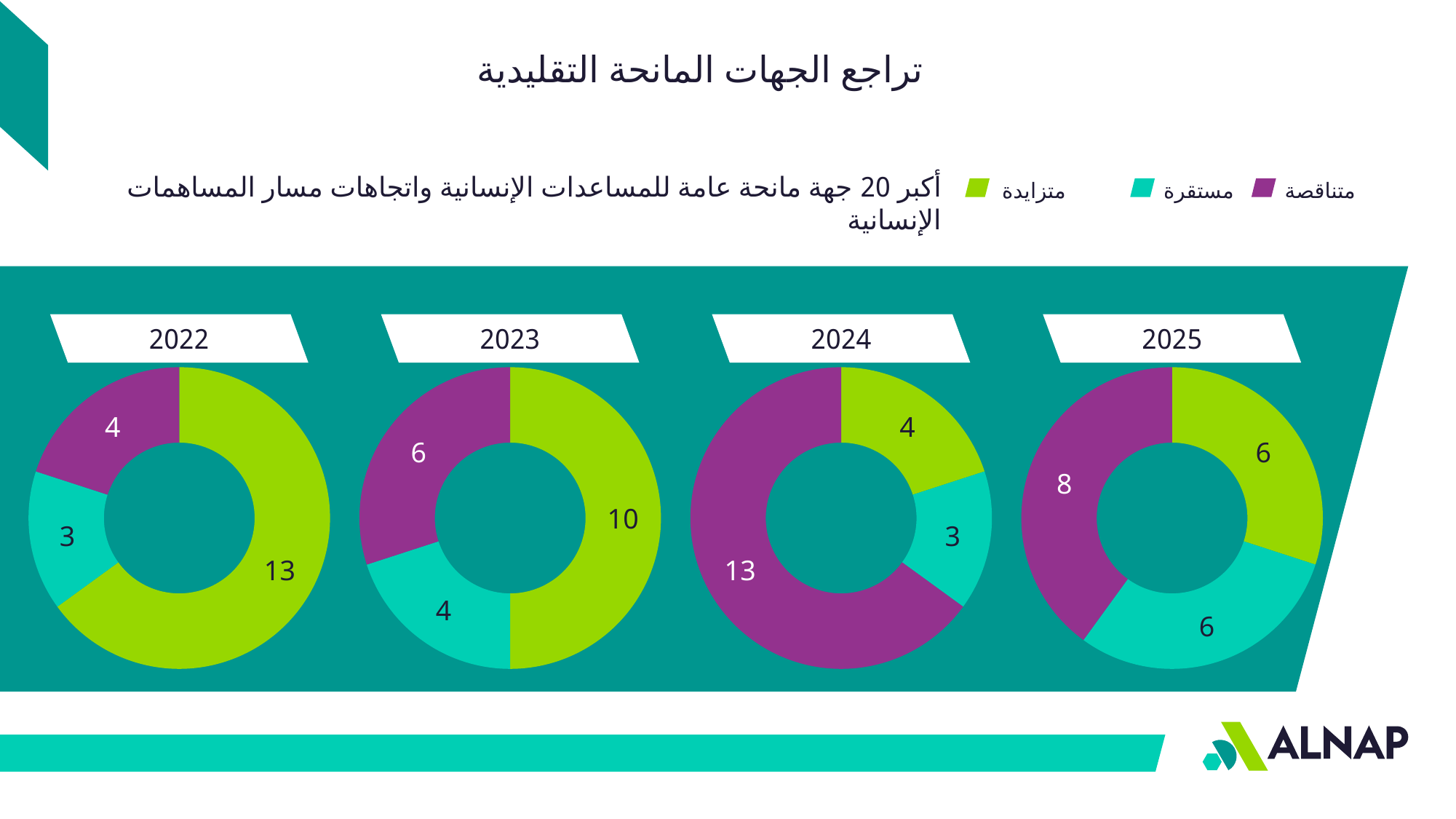
What is the total of all segments in the 2025 donut chart? 20 What share of the 2022 donut chart does متزايدة represent? 65% How many categories does the legend list? 3 In the 2022 donut chart, what is the value for متزايدة? 13 How many donut charts are shown on the slide? 4 In the 2025 donut chart, what is the value for مستقرة? 6 In the 2023 donut chart, which category has the highest value? متزايدة In the 2022 donut chart, which category has the lowest value? مستقرة In the 2024 donut chart, what is the value for متناقصة? 13 What kind of chart is used for each year on the slide? Donut chart In the 2023 donut chart, what is the difference between متزايدة and متناقصة? 4 In the 2024 donut chart, which is larger, متناقصة or متزايدة? متناقصة